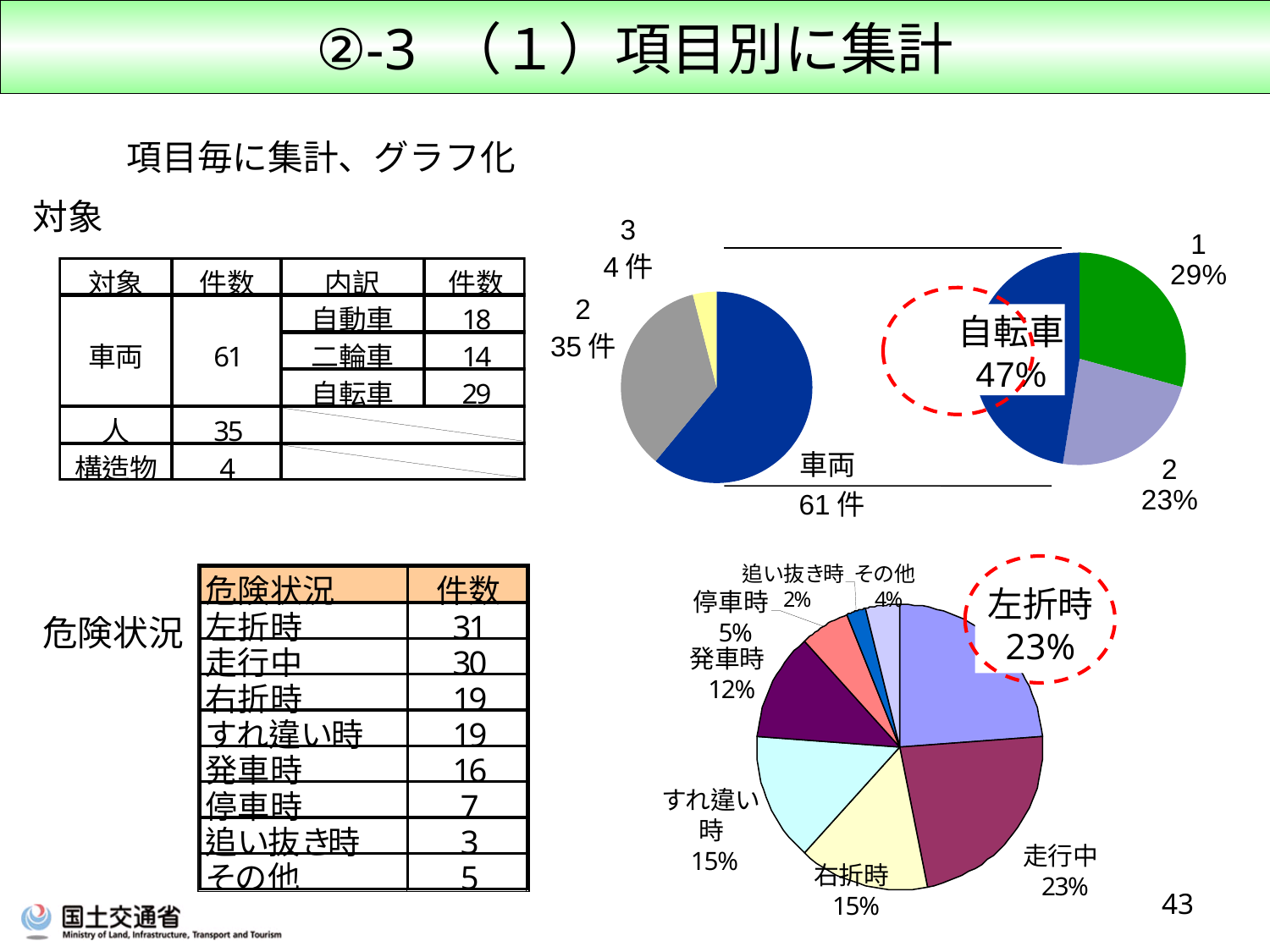
How many slices does the top-left pie chart have? 3 In the top-right pie chart, which slice is the largest? 自転車 In the top-right pie chart, what is the difference in percentage points between 自転車 and slice 1? 18% What type of chart is used for the 危険状況 data at the bottom of the slide? Pie chart In the bottom pie chart (危険状況), what is the difference in percentage points between 走行中 and 停車時? 18% In the bottom pie chart (危険状況), which slice is the smallest? 追い抜き時 In the top-left pie chart, how many cases (件) are shown for 車両? 61 件 In the bottom pie chart (危険状況), what share is shown for 発車時? 12% In the bottom pie chart (危険状況), what share is shown for 左折時? 23% In the top-right pie chart, what share is shown for 自転車? 47% In the bottom pie chart (危険状況), which is larger, 右折時 or 停車時? 右折時 How many slices does the bottom pie chart (危険状況) have? 8